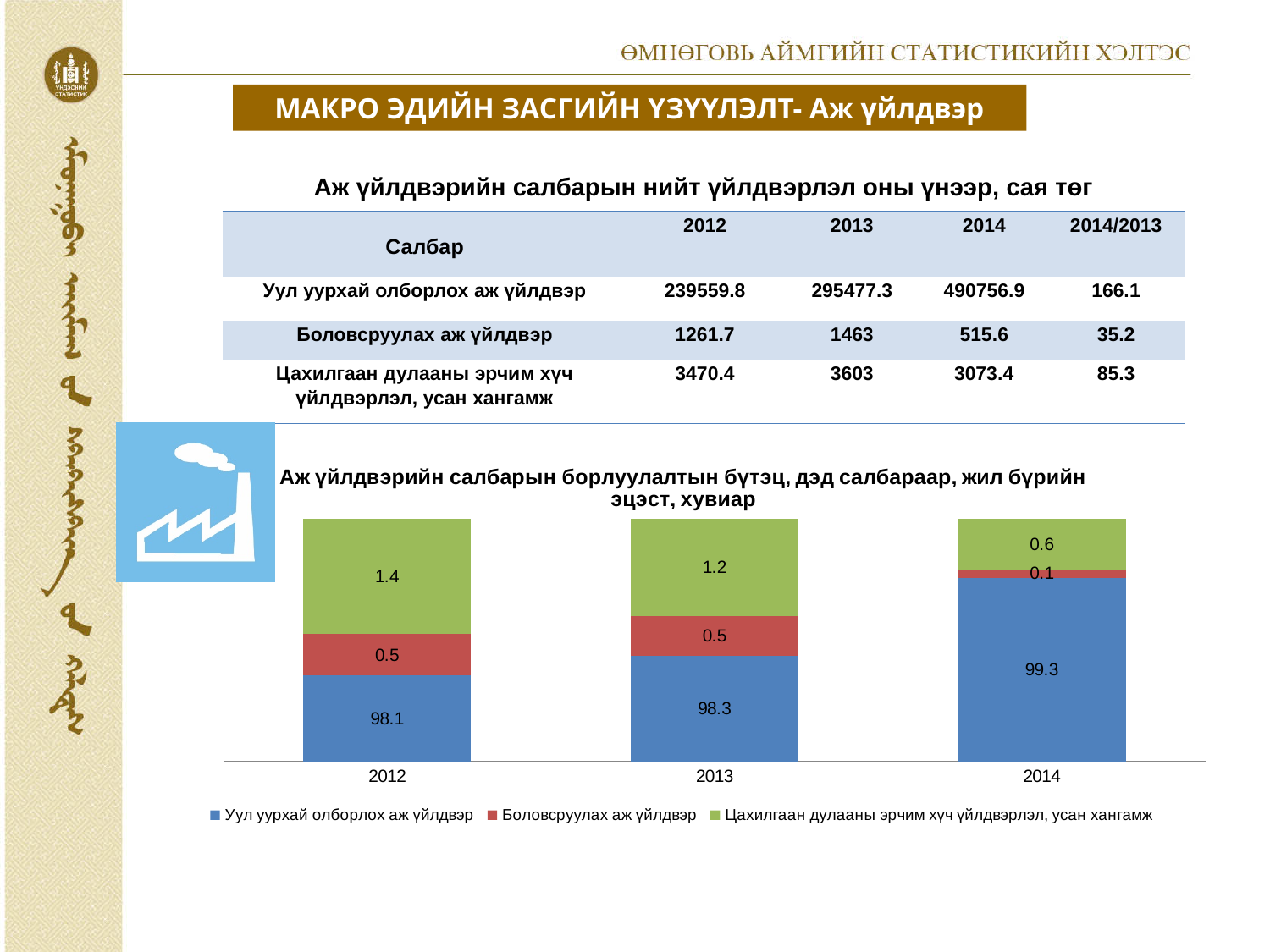
What type of chart is shown on the slide? Stacked bar chart How many years are shown on the x axis of the chart? 3 Which is larger: the Цахилгаан дулааны эрчим хүч үйлдвэрлэл, усан хангамж value in 2012 or in 2013? 2012 What is the value for Боловсруулах аж үйлдвэр in 2014? 0.1 What is the total of the stacked bar for 2014? 100 What is the difference between the Уул уурхай олборлох аж үйлдвэр values for 2014 and 2012? 1.2 In which year is the value for Цахилгаан дулааны эрчим хүч үйлдвэрлэл, усан хангамж lowest? 2014 What is the value for Цахилгаан дулааны эрчим хүч үйлдвэрлэл, усан хангамж in 2013? 1.2 How many series does the chart legend list? 3 In which year is the value for Уул уурхай олборлох аж үйлдвэр highest? 2014 Does the value for Уул уурхай олборлох аж үйлдвэр rise or fall from 2012 to 2014? Rise What is the value for Уул уурхай олборлох аж үйлдвэр in 2012? 98.1